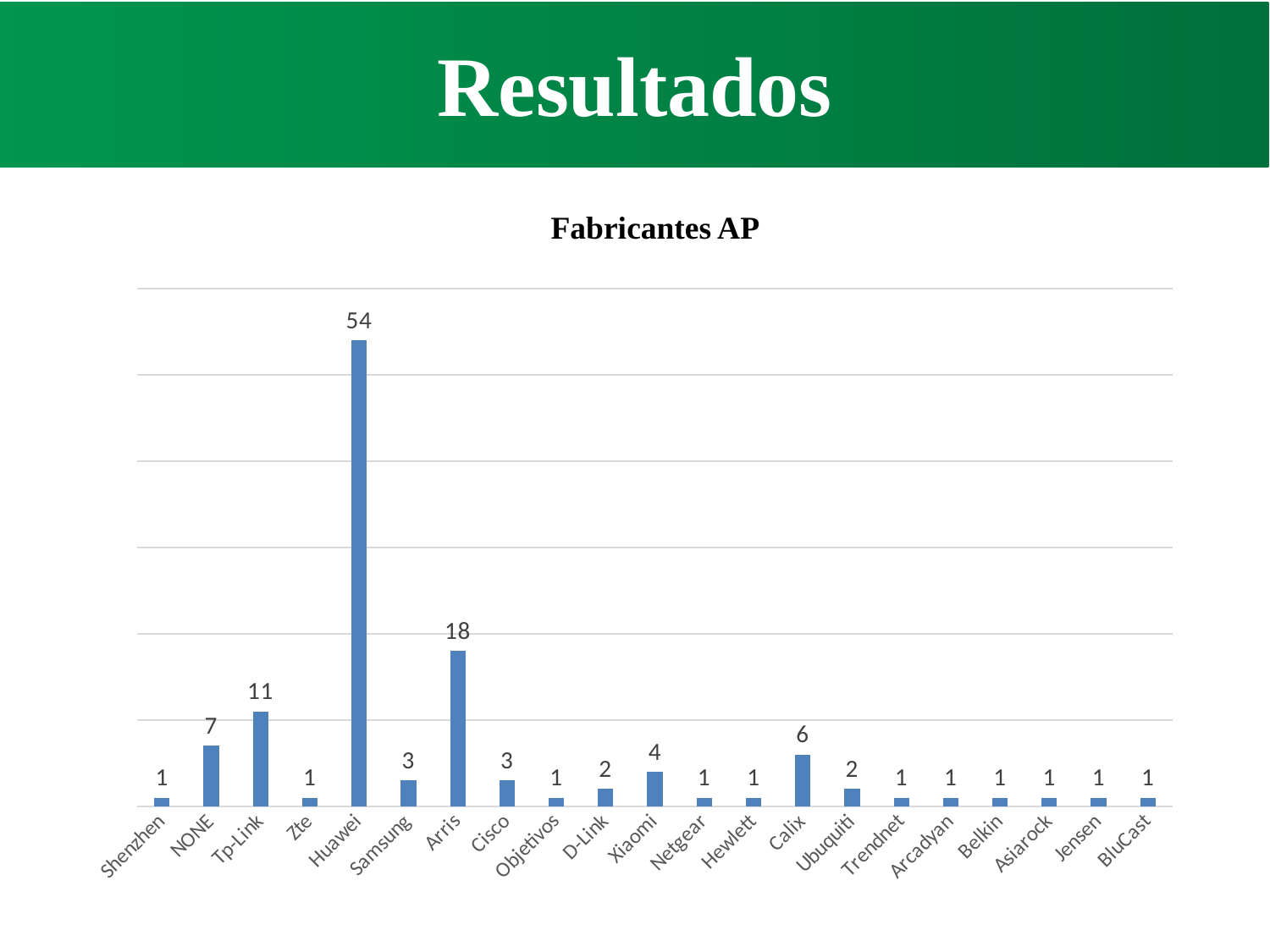
What is the value for Tp-Link in the Fabricantes AP chart? 11 How many manufacturers are shown in the Fabricantes AP chart? 21 What is the difference between the values for Huawei and Arris in the Fabricantes AP chart? 36 What is the difference between the values for Tp-Link and NONE in the Fabricantes AP chart? 4 Which has a larger value in the Fabricantes AP chart, Xiaomi or Calix? Calix Which manufacturer has the highest value in the Fabricantes AP chart? Huawei What is the value for Huawei in the Fabricantes AP chart? 54 What is the value for Arris in the Fabricantes AP chart? 18 What kind of chart is the Fabricantes AP chart? Bar chart What is the value for Calix in the Fabricantes AP chart? 6 Which has a larger value in the Fabricantes AP chart, Arris or Tp-Link? Arris What is the value for NONE in the Fabricantes AP chart? 7